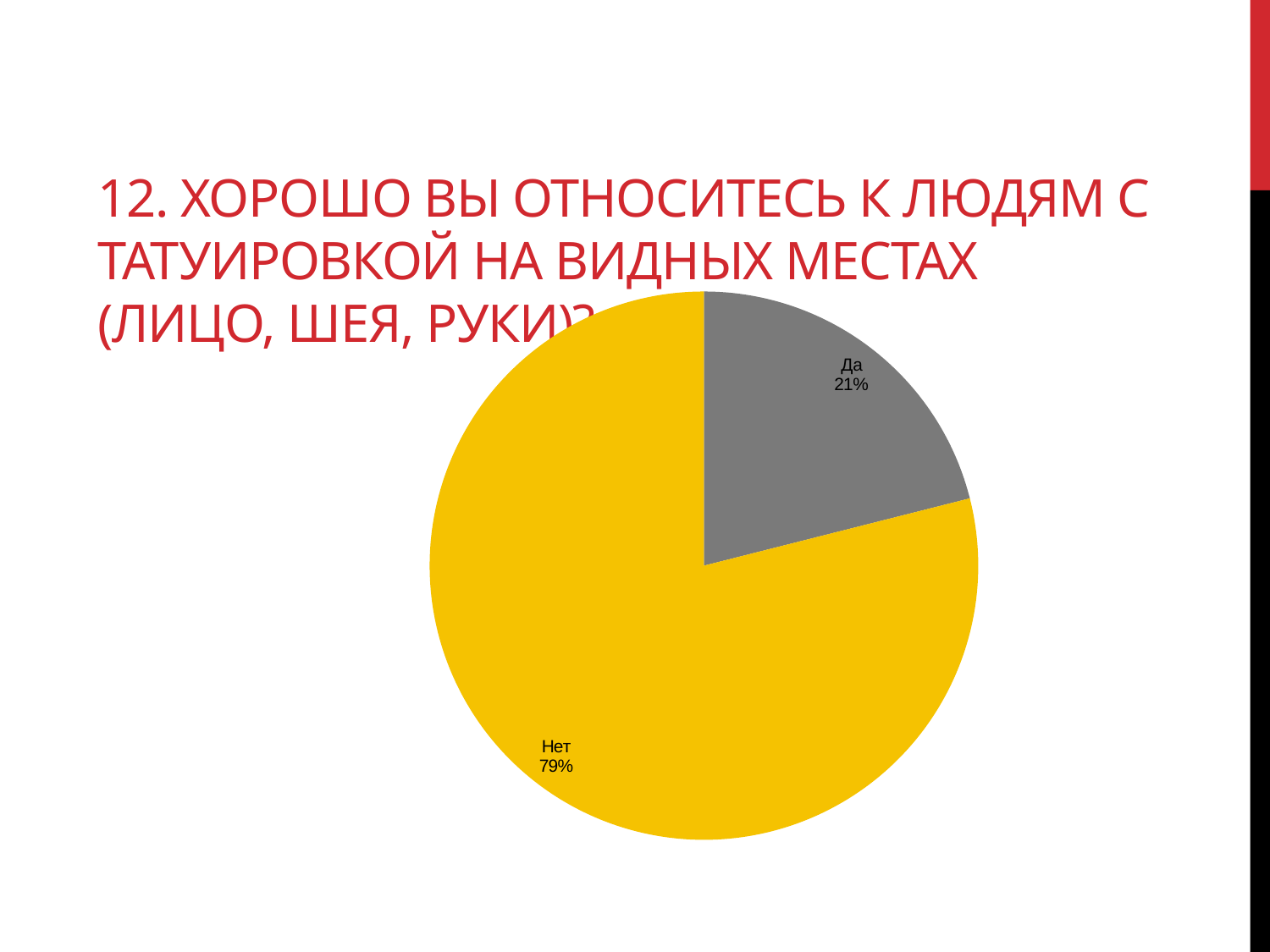
Which slice of the pie is the smallest? Да What colour is the "Да" slice? grey Which slice of the pie is the largest? Нет How many slices does the pie chart have? 2 What is the difference in percentage points between the "Нет" and "Да" slices? 58 Which is larger, the "Да" slice or the "Нет" slice? Нет What share of the pie does the "Нет" slice represent? 79% What colour is the "Нет" slice? yellow What kind of chart is shown on the slide? pie chart What share of the pie does the "Да" slice represent? 21%